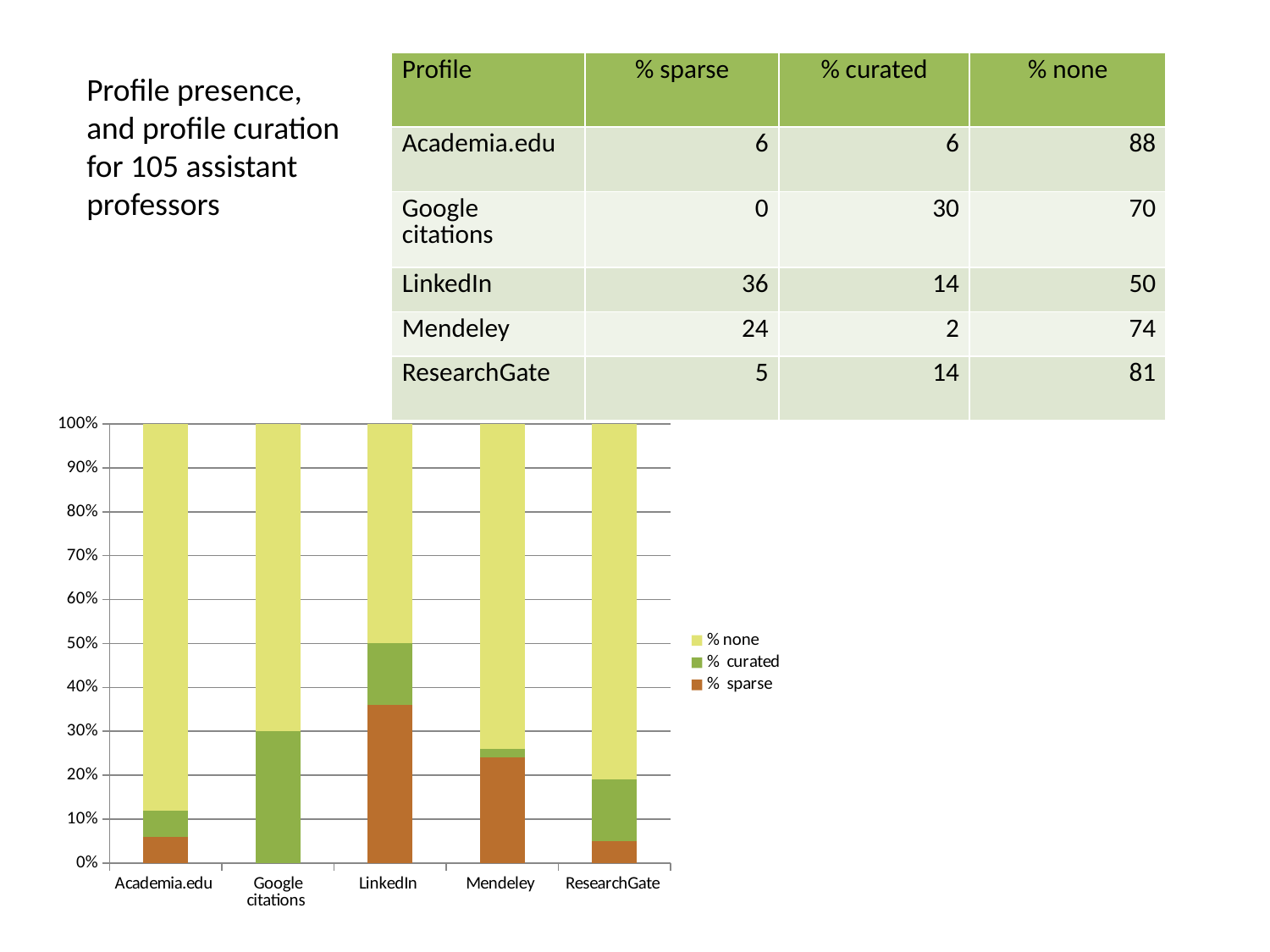
Which profile has the lowest % none value? LinkedIn What is the difference between the % none values for Academia.edu and LinkedIn? 38 Which is larger, the % curated value for ResearchGate or the % curated value for Mendeley? ResearchGate Which series is shown in the lightest (yellow-green) colour in the chart? % none What is the % none value for Academia.edu? 88 Which profile has the highest % sparse value? LinkedIn What kind of chart is shown on the slide? stacked bar chart Is the % sparse value for Mendeley greater or less than 20%? greater What is the % curated value for Google citations? 30 How many profile categories are shown on the x axis of the chart? 5 What is the % sparse value for LinkedIn? 36 How many series does the chart legend list? 3